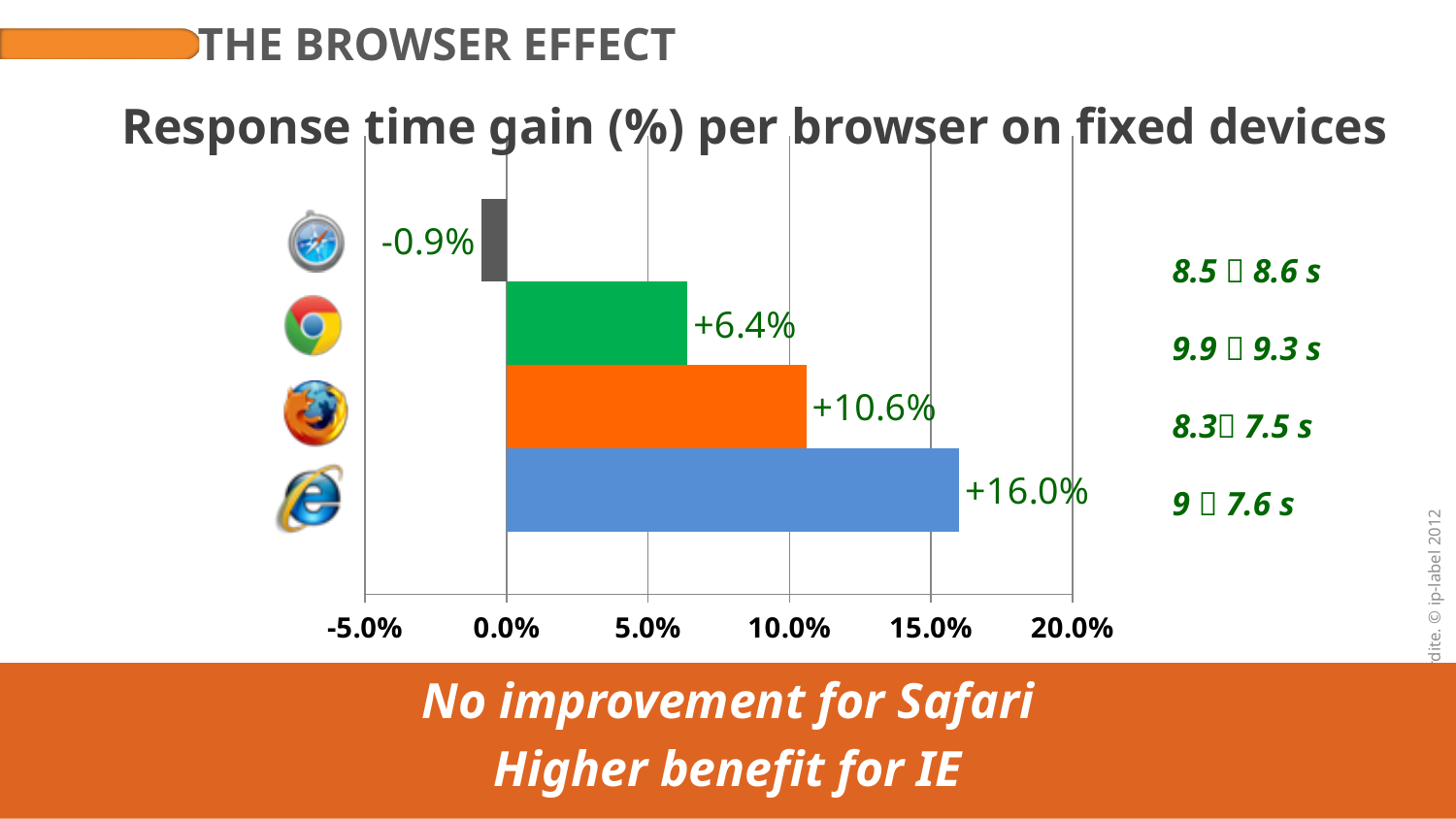
What is the response time gain for Chrome? +6.4% What type of chart is shown on the slide? Bar chart What is the response time gain for Firefox? +10.6% What is the difference in percentage points between the gain for Internet Explorer and the gain for Firefox? 5.4 percentage points What is the title of the chart? Response time gain (%) per browser on fixed devices Which browser has the highest response time gain? Internet Explorer What is the difference in percentage points between the gain for Firefox and the gain for Chrome? 4.2 percentage points How many browsers are shown in the chart? 4 Which has a larger response time gain, Chrome or Firefox? Firefox What is the response time gain for Internet Explorer? +16.0% What is the response time gain for Safari? -0.9% Which browser has the lowest response time gain? Safari